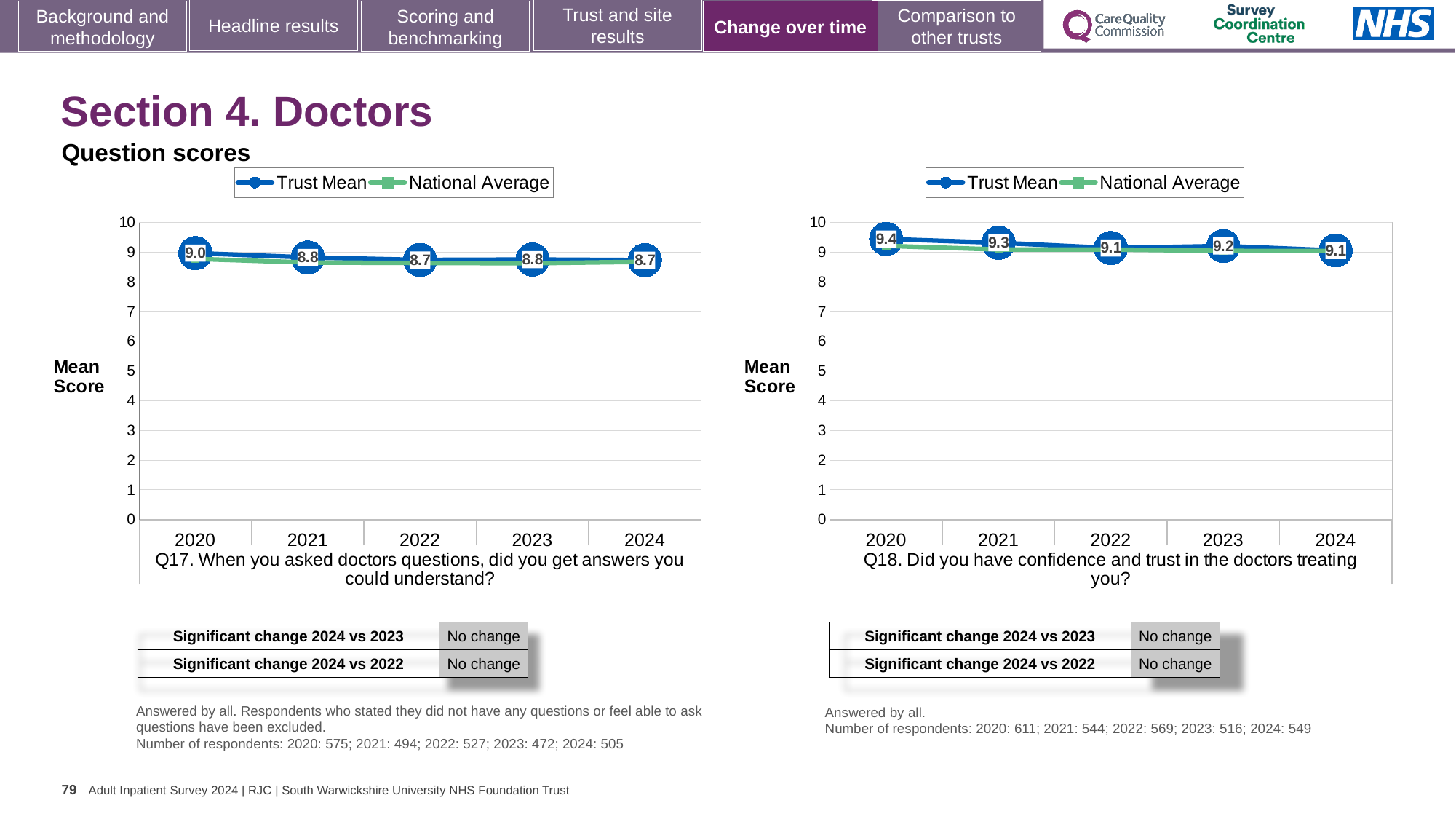
How many years are plotted on the x axis of the Q18 chart (right)? 5 What type of chart is used for Q17 (left)? Line chart In the Q18 chart (right), which year has the highest Trust Mean score? 2020 How many series does the legend of the Q17 chart (left) list? 2 In the Q17 chart (left), what is the difference between the Trust Mean score in 2020 and in 2024? 0.3 In the Q18 chart (right), what is the Trust Mean score for 2023? 9.2 In the Q17 chart (left), what is the Trust Mean score for 2024? 8.7 In the Q18 chart (right), what is the Trust Mean score for 2020? 9.4 In the Q18 chart (right), what is the difference between the Trust Mean score in 2020 and in 2022? 0.3 In the Q17 chart (left), is the National Average value for 2024 greater or less than 8? greater In the Q17 chart (left), what is the Trust Mean score for 2020? 9.0 Is the Trust Mean score for 2020 in the Q17 chart (left) larger or smaller than the Trust Mean score for 2020 in the Q18 chart (right)? smaller